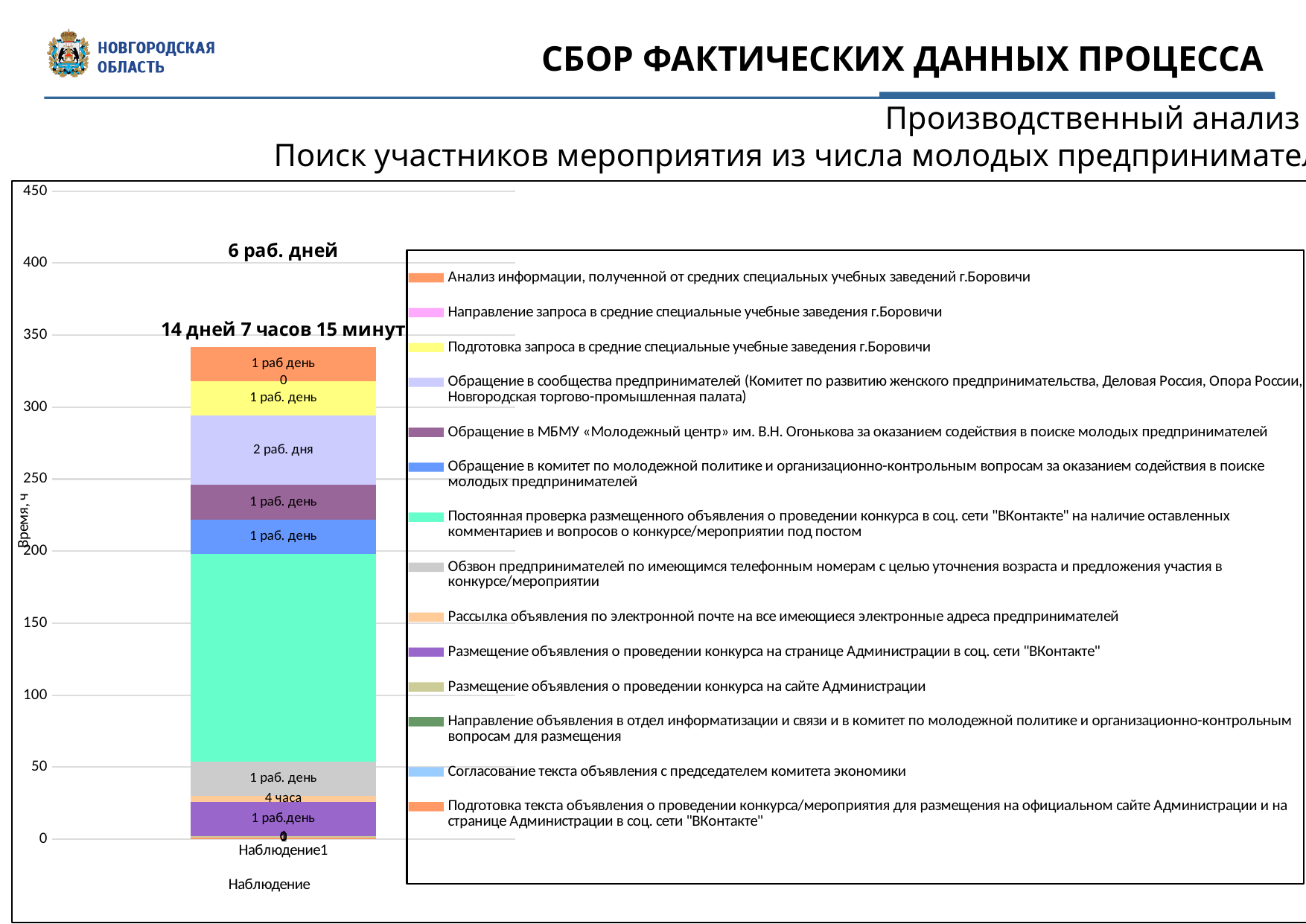
How many series does the chart's legend list? 14 What data label is printed on the segment for 'Обращение в сообщества предпринимателей'? 2 раб. дня Is the total height of the stacked bar for Наблюдение1 greater or less than 300? greater What kind of chart is shown on the slide? Stacked bar chart How many categories are plotted on the x axis of the chart? 1 Which series occupies the largest segment of the stacked bar? Постоянная проверка размещенного объявления о проведении конкурса в соц. сети "ВКонтакте" на наличие оставленных комментариев и вопросов о конкурсе/мероприятии под постом Is the total height of the stacked bar for Наблюдение1 greater or less than 350? less What data label is printed on the segment for 'Рассылка объявления по электронной почте на все имеющиеся электронные адреса предпринимателей'? 4 часа What data label is printed on the segment for 'Размещение объявления о проведении конкурса на странице Администрации в соц. сети "ВКонтакте"'? 1 раб.день What is the label of the single category on the x axis? Наблюдение1 What data label is printed on the segment for 'Обзвон предпринимателей по имеющимся телефонным номерам'? 1 раб. день What is the title of the vertical axis? Время, ч